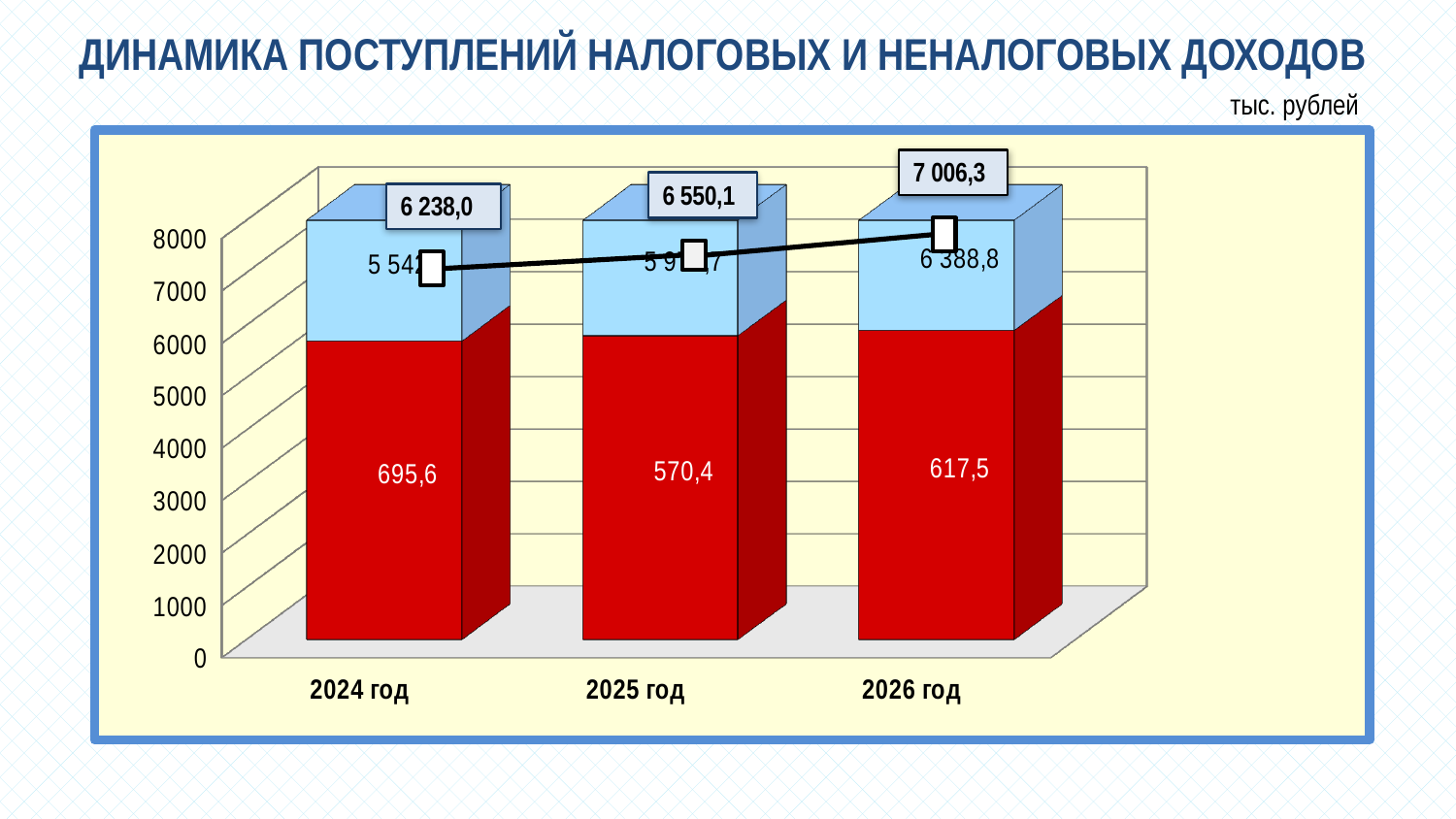
What is the total value shown above the bar for 2024 год? 6 238,0 Do the total values rise or fall from 2024 год to 2026 год? rise How many years are shown on the x axis? 3 What is the value of the red segment for 2025 год? 570,4 What is the total value shown above the bar for 2026 год? 7 006,3 Which year has the lowest red segment value? 2025 год What is the difference between the total for 2026 год and the total for 2024 год? 768,3 What is the value of the light blue segment for 2026 год? 6 388,8 What is the value of the red segment for 2024 год? 695,6 Which year has the highest total value? 2026 год What is the value of the red segment for 2026 год? 617,5 What is the total value shown above the bar for 2025 год? 6 550,1